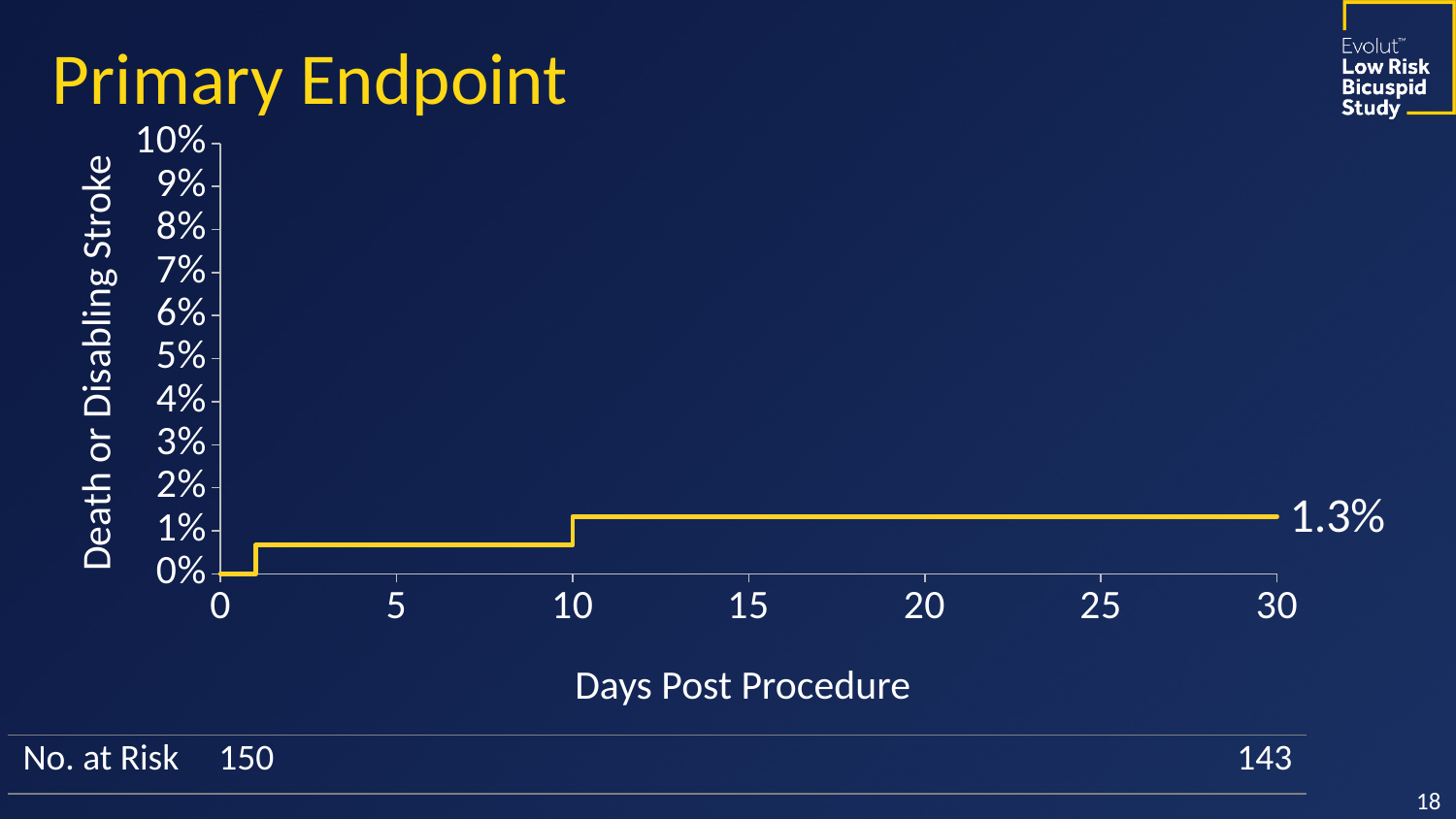
Does the Death or Disabling Stroke curve rise or fall as days post procedure increase? rise What is the value of Death or Disabling Stroke at day 0? 0% What is the highest value shown on the y axis? 10% Is the value for Death or Disabling Stroke at day 20 greater or less than 1%? greater What is the number at risk at day 30? 143 Is the value for Death or Disabling Stroke at day 30 greater or less than 2%? less What kind of chart is shown on the slide? line chart What is the number at risk at day 0? 150 What is the label of the x axis? Days Post Procedure Is the value for Death or Disabling Stroke at day 5 greater or less than 1%? less What is the value of Death or Disabling Stroke at day 30, as labeled on the chart? 1.3%